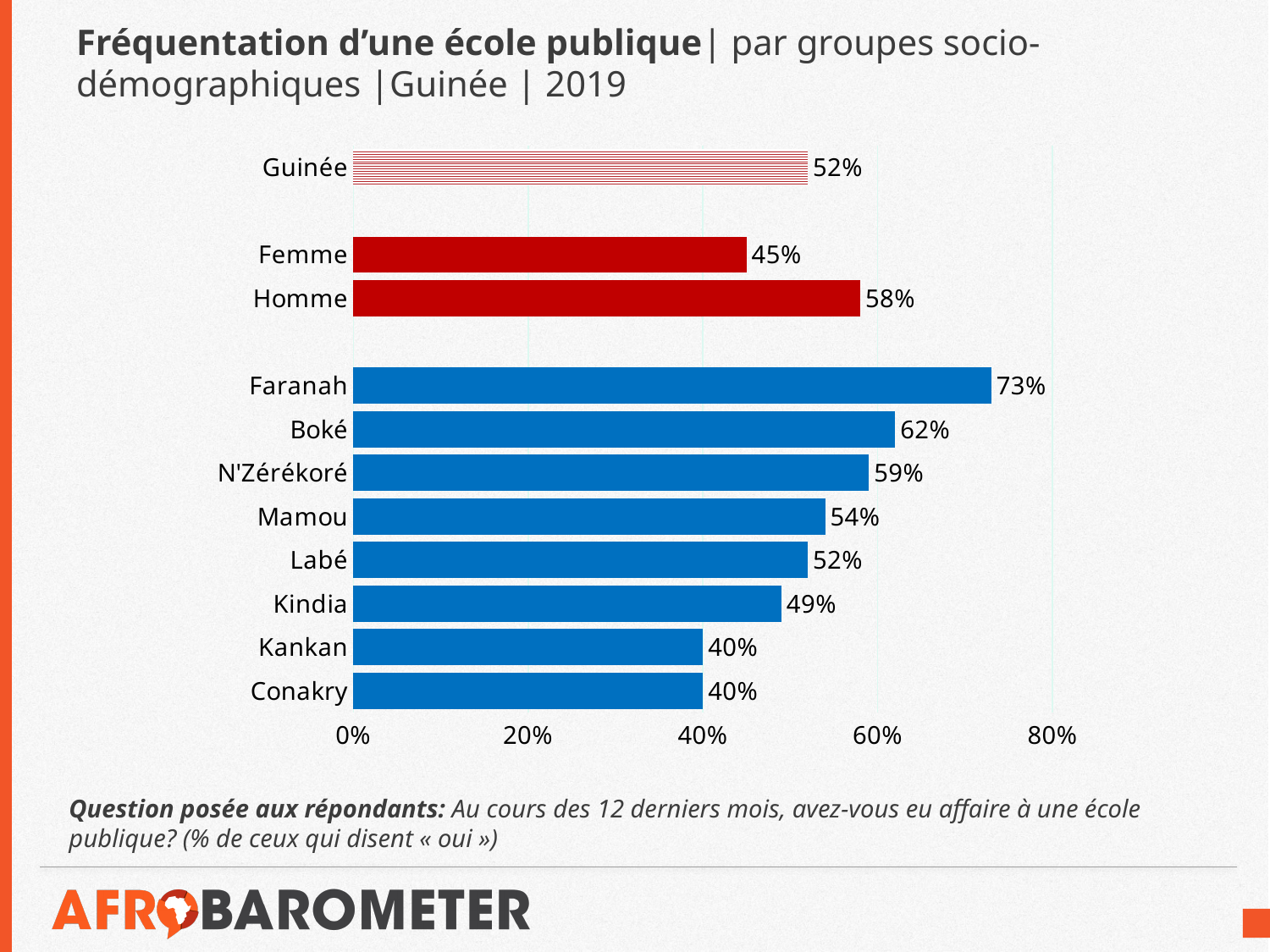
What is the difference between Homme and Femme? 13 percentage points What kind of chart is this? Bar chart What colour are the bars for Femme and Homme? Red Is the value for Mamou greater or less than 60%? less Which region has the highest value? Faranah Which is larger, Boké or N'Zérékoré? Boké What is the value for Femme? 45% What is the value for Guinée overall? 52% How many regions are shown in the blue bars? 8 What is the difference between Faranah and Conakry? 33 percentage points What is the value for Faranah? 73% Which category has the lowest value on the chart? Kankan and Conakry (40%)